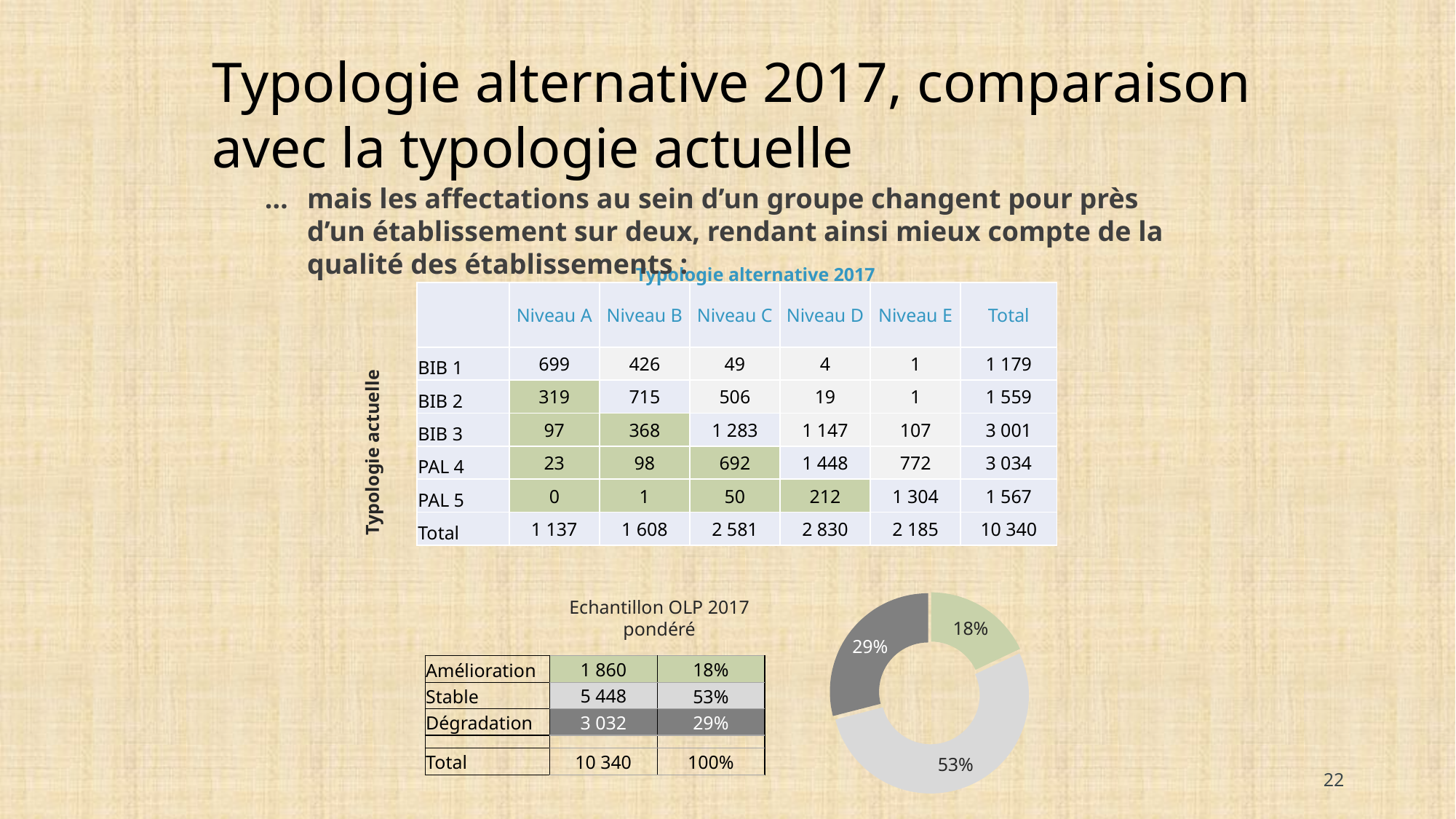
What kind of chart is shown at the bottom right of the slide? Doughnut (pie) chart In the doughnut chart, what share of the total does the 'Dégradation' category (dark grey) represent? 29% In the doughnut chart, what share of the total does the 'Stable' category (light grey) represent? 53% In the doughnut chart, what is the difference in percentage points between the largest slice (53%) and the smallest slice (18%)? 35 percentage points In the doughnut chart, what is the value of the light green slice? 18% In the doughnut chart, what percentage is shown on the largest slice? 53% How many slices does the doughnut chart at the bottom right have? 3 In the doughnut chart, what is the value of the dark grey slice? 29% In the doughnut chart, what is the value of the light grey slice? 53% In the doughnut chart, what percentage is shown on the smallest slice? 18% In the doughnut chart, which slice is larger: the dark grey one (29%) or the light green one (18%)? The dark grey one (29%) What colour is the 'Amélioration' slice in the doughnut chart? Light green